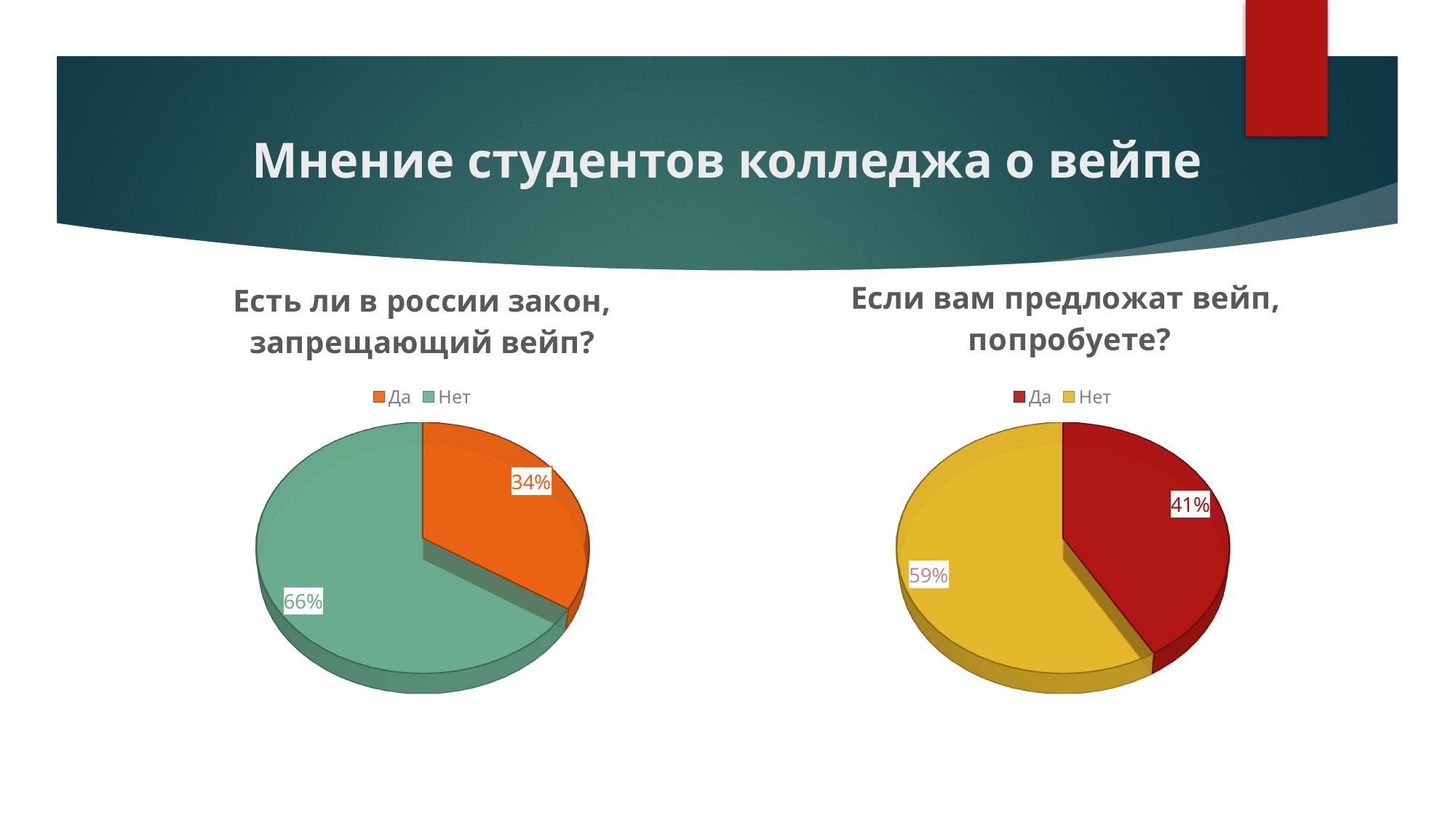
What type of chart is the left chart? Pie chart What colour is the 'Нет' slice in the right chart? Yellow In the right chart, which answer has the smallest share? Да In the right chart, what is the difference between the 'Нет' and 'Да' shares? 18% In the left chart, what is the difference between the 'Нет' and 'Да' shares? 32% In the right chart 'Если вам предложат вейп, попробуете?', what percentage answered 'Нет'? 59% In the right chart 'Если вам предложат вейп, попробуете?', what percentage answered 'Да'? 41% In the left chart, which answer has the largest share? Нет How many entries does the legend of the right chart list? 2 In the left chart 'Есть ли в россии закон, запрещающий вейп?', what percentage answered 'Да'? 34% Which is larger: the 'Да' share in the left chart or the 'Да' share in the right chart? The 'Да' share in the right chart In the left chart 'Есть ли в россии закон, запрещающий вейп?', what percentage answered 'Нет'? 66%